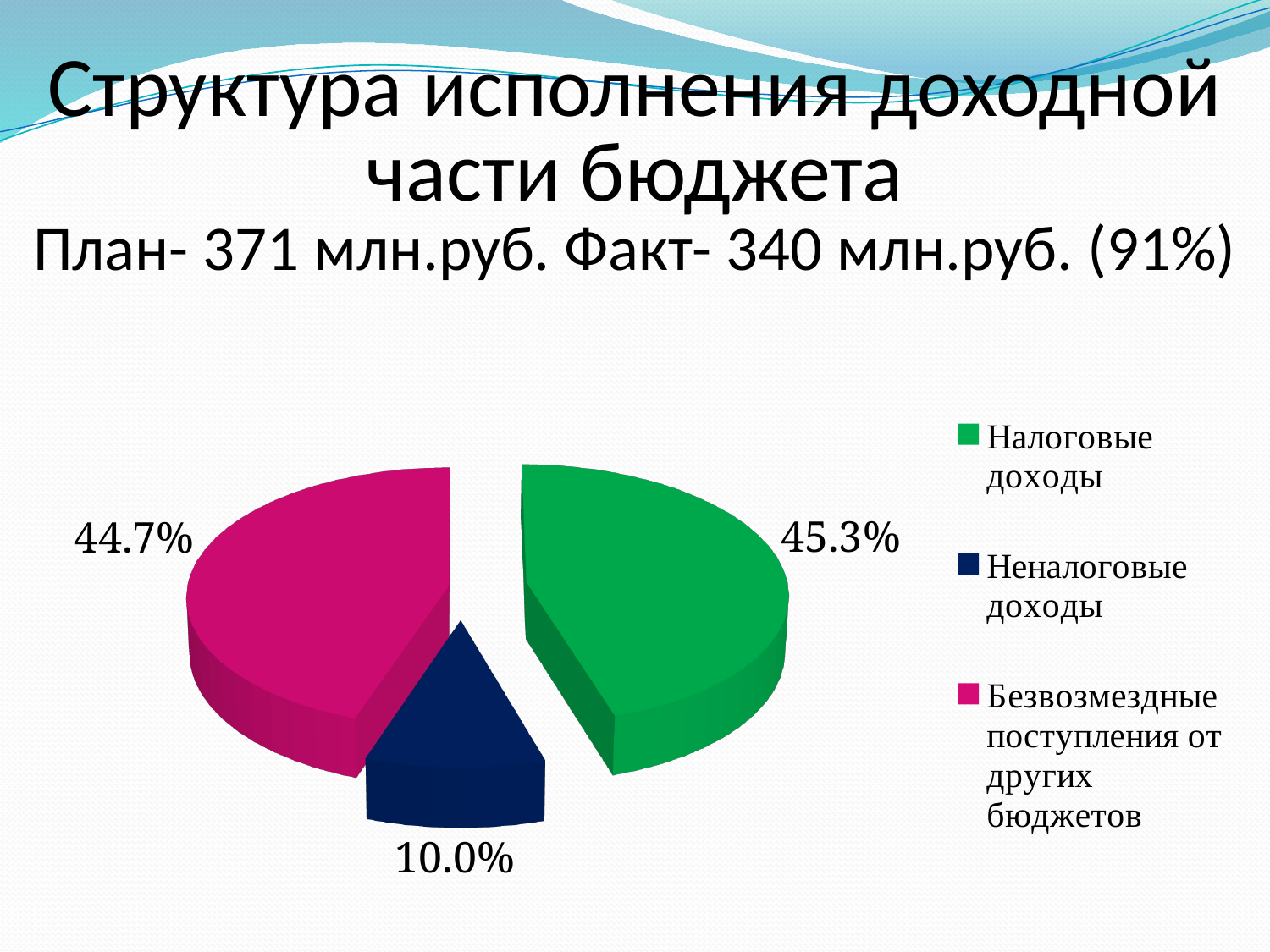
Which category has the largest slice of the pie? Налоговые доходы How many slices does the pie chart have? 3 Which category has the smallest slice of the pie? Неналоговые доходы According to the slide title, what is the planned revenue amount? 371 млн.руб. What is the difference in percentage points between Налоговые доходы and Безвозмездные поступления от других бюджетов? 0.6 What share of the pie does Неналоговые доходы represent? 10.0% What kind of chart is shown on the slide? Pie chart Which is larger: the share for Неналоговые доходы or the share for Безвозмездные поступления от других бюджетов? Безвозмездные поступления от других бюджетов What share of the pie does Налоговые доходы represent? 45.3% What is the difference in percentage points between Налоговые доходы and Неналоговые доходы? 35.3 What share of the pie does Безвозмездные поступления от других бюджетов represent? 44.7% What colour is the slice for Неналоговые доходы? Dark blue